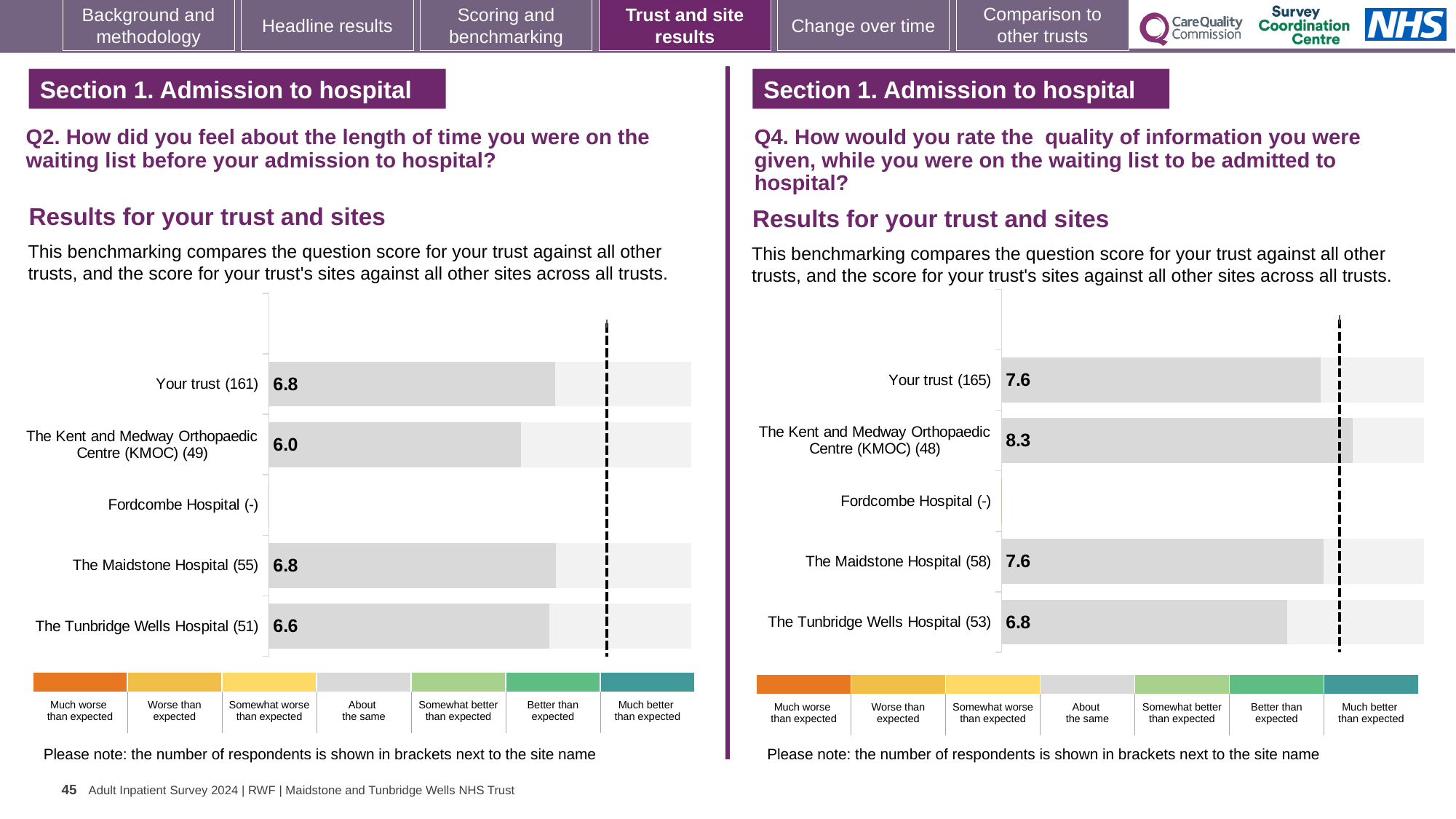
In the Q2 chart on the left, what is the score for The Kent and Medway Orthopaedic Centre (KMOC)? 6.0 In the Q2 chart on the left, what is the score for The Tunbridge Wells Hospital? 6.6 In the Q4 chart on the right, what is the score for The Tunbridge Wells Hospital? 6.8 In the Q4 chart on the right, which site has the highest score? The Kent and Medway Orthopaedic Centre (KMOC) In the Q4 chart on the right, what is the difference between the KMOC score and the Tunbridge Wells Hospital score? 1.5 In the Q4 chart on the right, what is the score for The Kent and Medway Orthopaedic Centre (KMOC)? 8.3 In the Q4 chart on the right, how many respondents are shown for Your trust? 165 In the Q2 chart on the left, which site has the lowest score? The Kent and Medway Orthopaedic Centre (KMOC) What type of chart is used in the Q4 chart on the right? Bar chart In the Q2 chart on the left, which has the larger score: The Maidstone Hospital or The Tunbridge Wells Hospital? The Maidstone Hospital In the Q2 chart on the left, what is the difference between the Your trust score and the KMOC score? 0.8 How many site rows (including Your trust) are listed in the Q2 chart on the left? 5